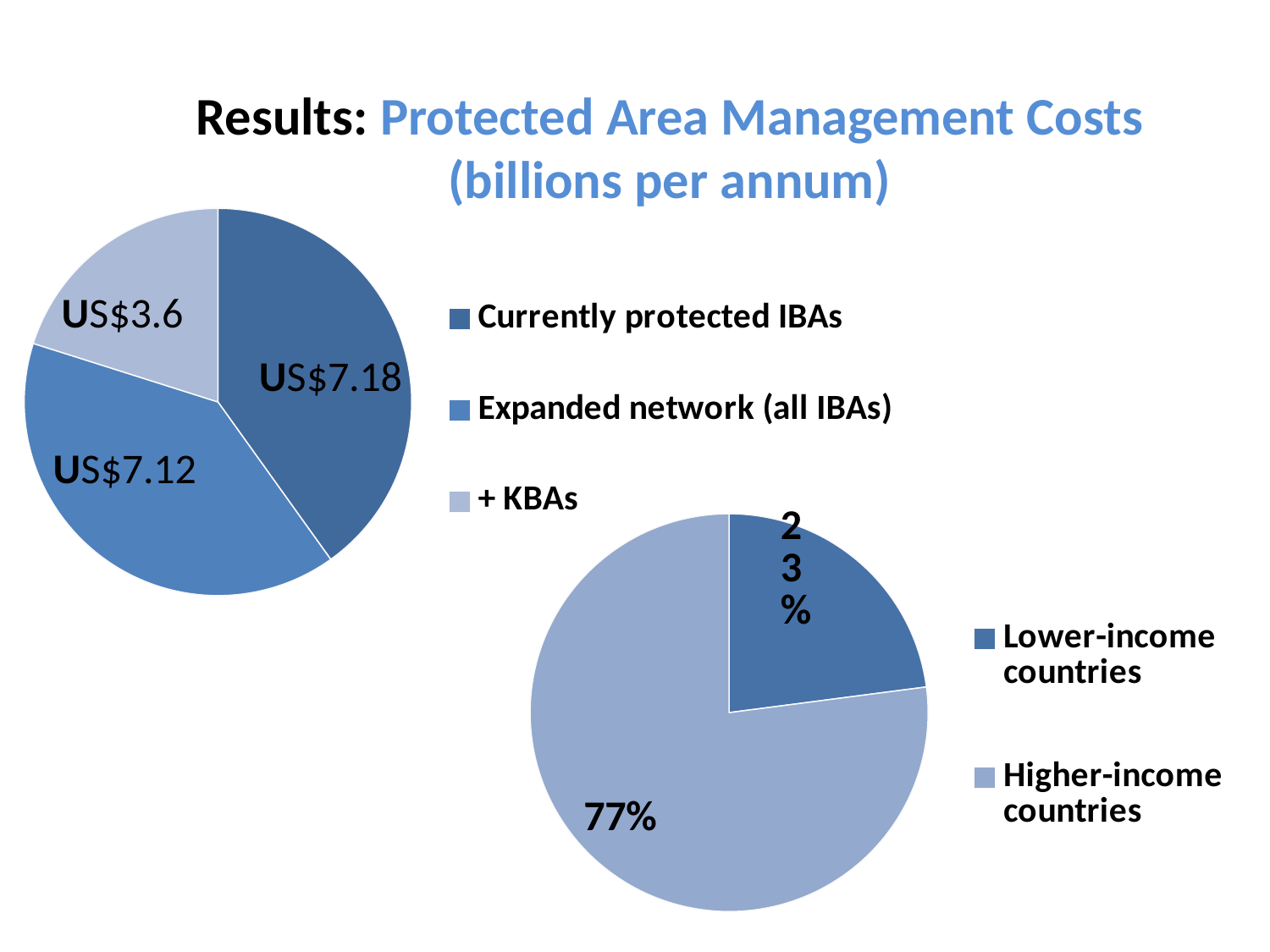
How many slices does the top-left pie chart have? 3 In the bottom-right pie chart, what is the difference in percentage points between Higher-income countries and Lower-income countries? 54 percentage points In the top-left pie chart, what is the difference between the values for Currently protected IBAs and + KBAs? US$3.58 In the top-left pie chart, which is larger: Currently protected IBAs or + KBAs? Currently protected IBAs What type of chart is the top-left chart? Pie chart In the bottom-right pie chart, what share is shown for Lower-income countries? 23% In the top-left pie chart, what is the value for Currently protected IBAs? US$7.18 In the bottom-right pie chart, what share is shown for Higher-income countries? 77% In the bottom-right pie chart, which category has the largest share? Higher-income countries In the top-left pie chart, what is the value for + KBAs? US$3.6 In the top-left pie chart, what is the value for Expanded network (all IBAs)? US$7.12 In the top-left pie chart, which category has the smallest value? + KBAs